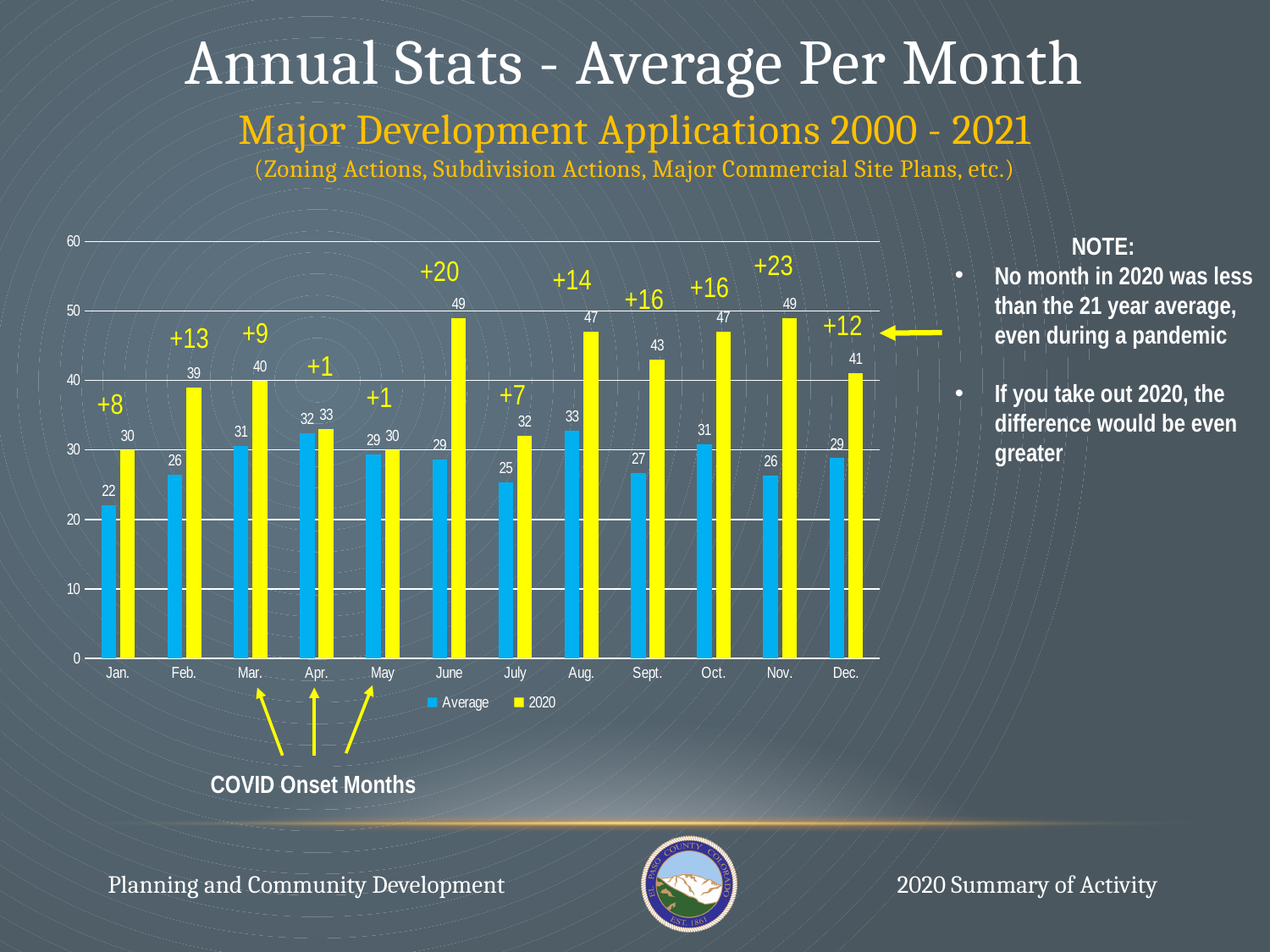
What is the difference between the 2020 value and the Average value for November? 23 How many series does the legend list? 2 How many months are shown on the x axis? 12 What is the 2020 value for September? 43 Which month has the highest Average value? Aug. What is the 2020 value for June? 49 What kind of chart is shown on the slide? bar chart What is the Average value for August? 33 Which is larger for April, the Average value or the 2020 value? 2020 Which month has the lowest Average value? Jan. Which colour represents the 2020 series in the chart? yellow Is the 2020 value for October greater or less than 40? greater